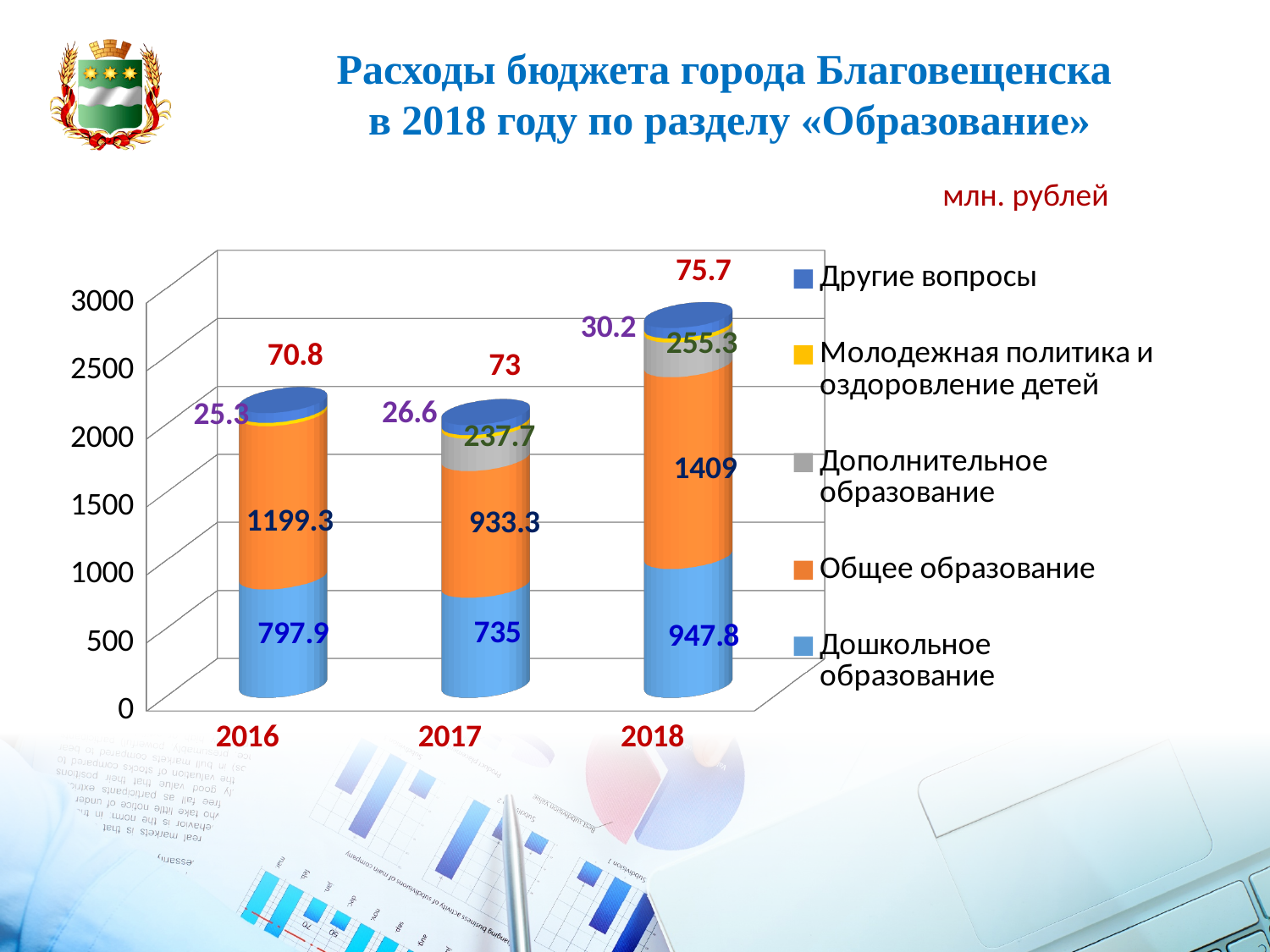
What is the value for Общее образование in 2017? 933.3 In which year is the value for Дошкольное образование the lowest? 2017 In which year is the value for Общее образование the highest? 2018 How many years are shown on the x axis? 3 What is the total of the stacked bar for 2018? 2718 What is the value for Дополнительное образование in 2018? 255.3 How many series does the legend list? 5 What is the difference between the Общее образование values for 2018 and 2016? 209.7 What is the value for Дошкольное образование in 2018? 947.8 What is the value for Другие вопросы in 2016? 70.8 What kind of chart is shown on the slide? Stacked bar chart Which year has the larger value for Дошкольное образование, 2016 or 2017? 2016